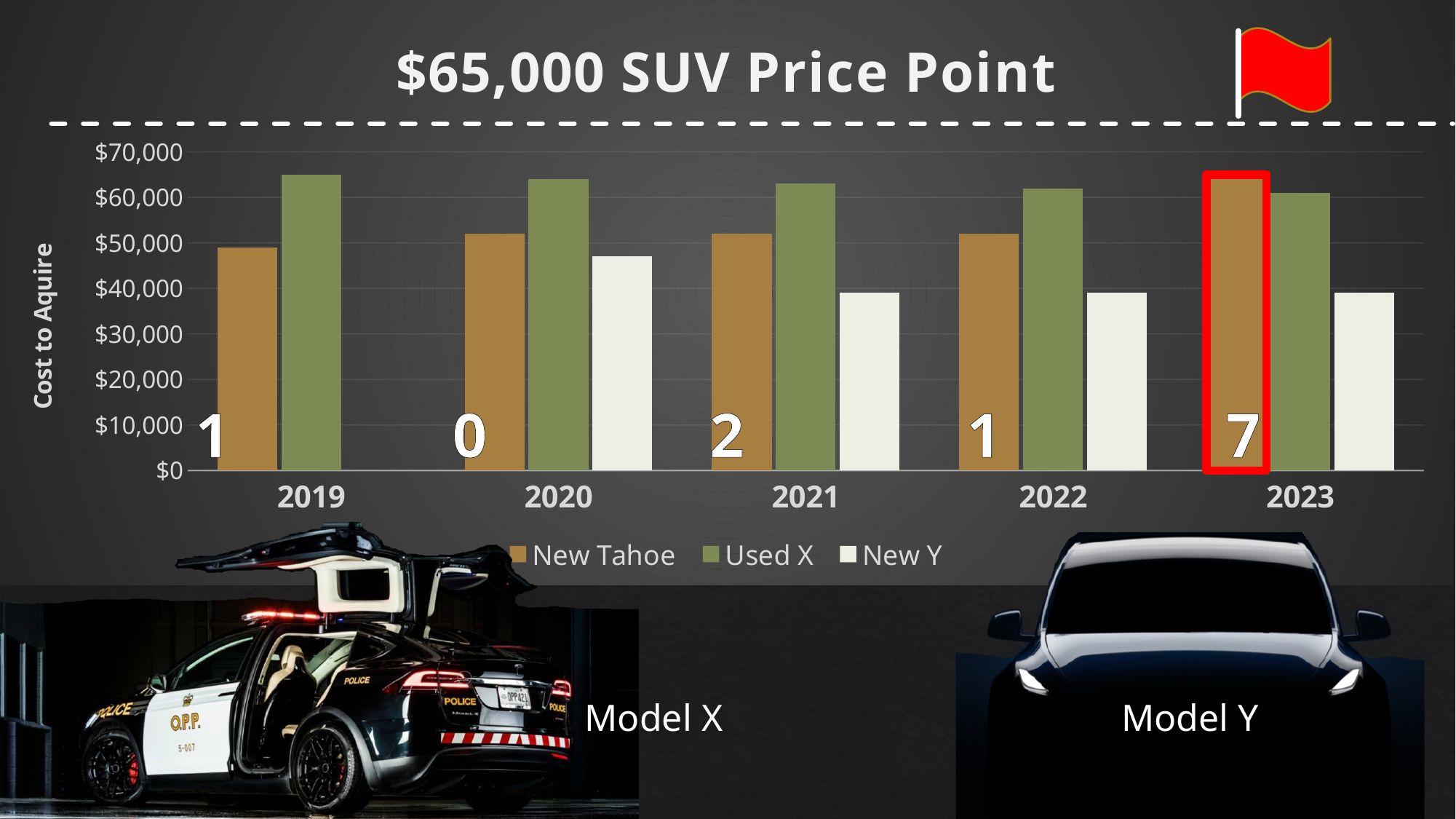
Is the value for Used X in 2019 greater or less than $60,000? greater What kind of chart is shown on the slide? bar chart In which year is the New Tahoe value highest? 2023 Do the Used X values rise or fall from 2019 to 2023? fall In 2020, which series has the higher value, New Tahoe or New Y? New Tahoe Is the value for New Tahoe in 2023 greater or less than $60,000? greater What are the three series named in the legend? New Tahoe, Used X, New Y What is the title of the chart? $65,000 SUV Price Point How many series does the chart legend list? 3 How many years are shown on the x axis of the chart? 5